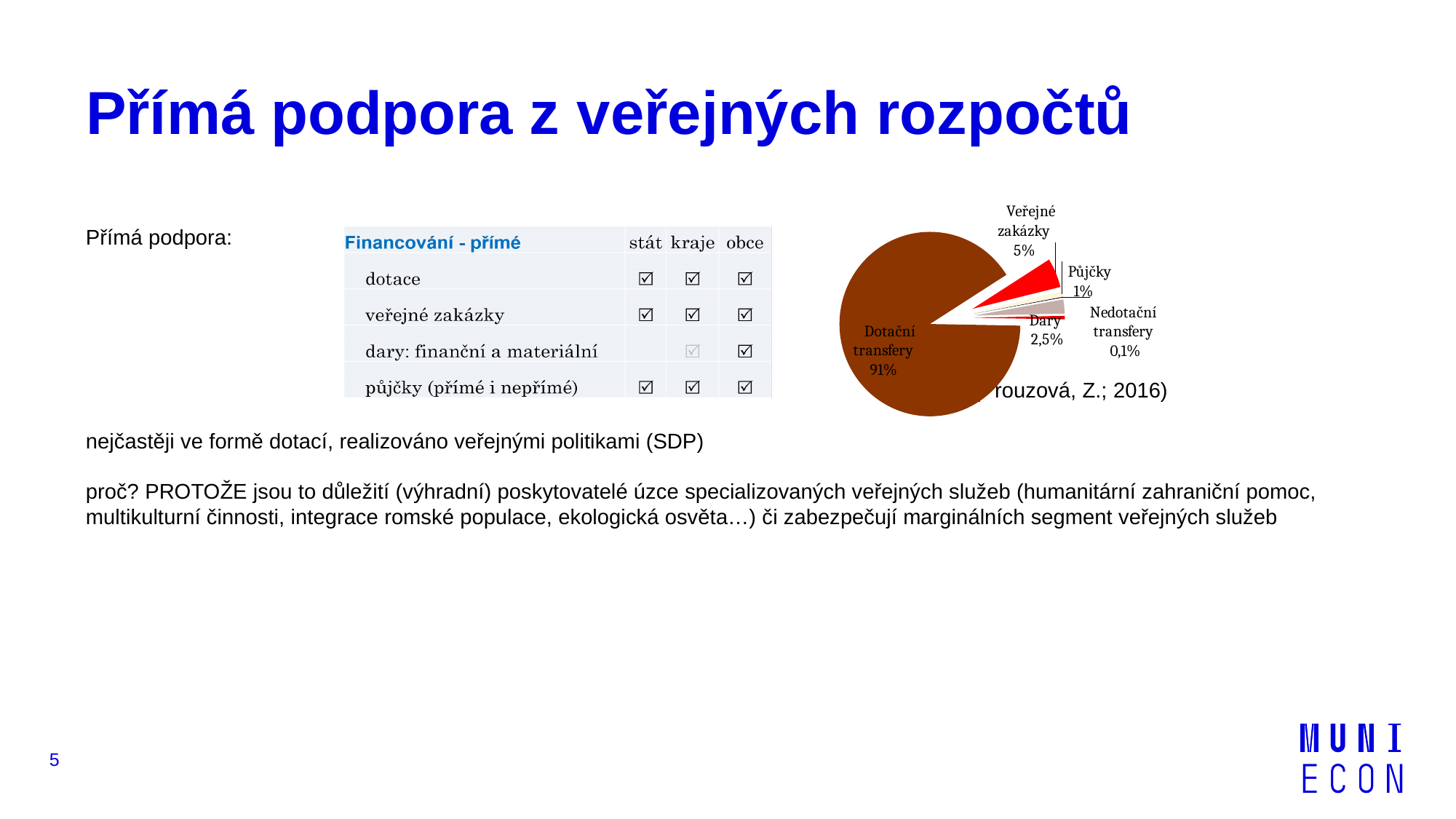
What kind of chart is shown on the slide? pie chart What is the difference in percentage points between Veřejné zakázky and Dary? 2,5% How many slices does the pie chart have? 6 What share of the pie does Veřejné zakázky have? 5% What colour is the Dotační transfery slice in the pie chart? brown Which slice of the pie chart is the largest? Dotační transfery What share of the pie does Půjčky have? 1% Which is larger in the pie chart, Půjčky or Dary? Dary What share of the pie does Dotační transfery have? 91% Which slice of the pie chart is the smallest? Nedotační transfery